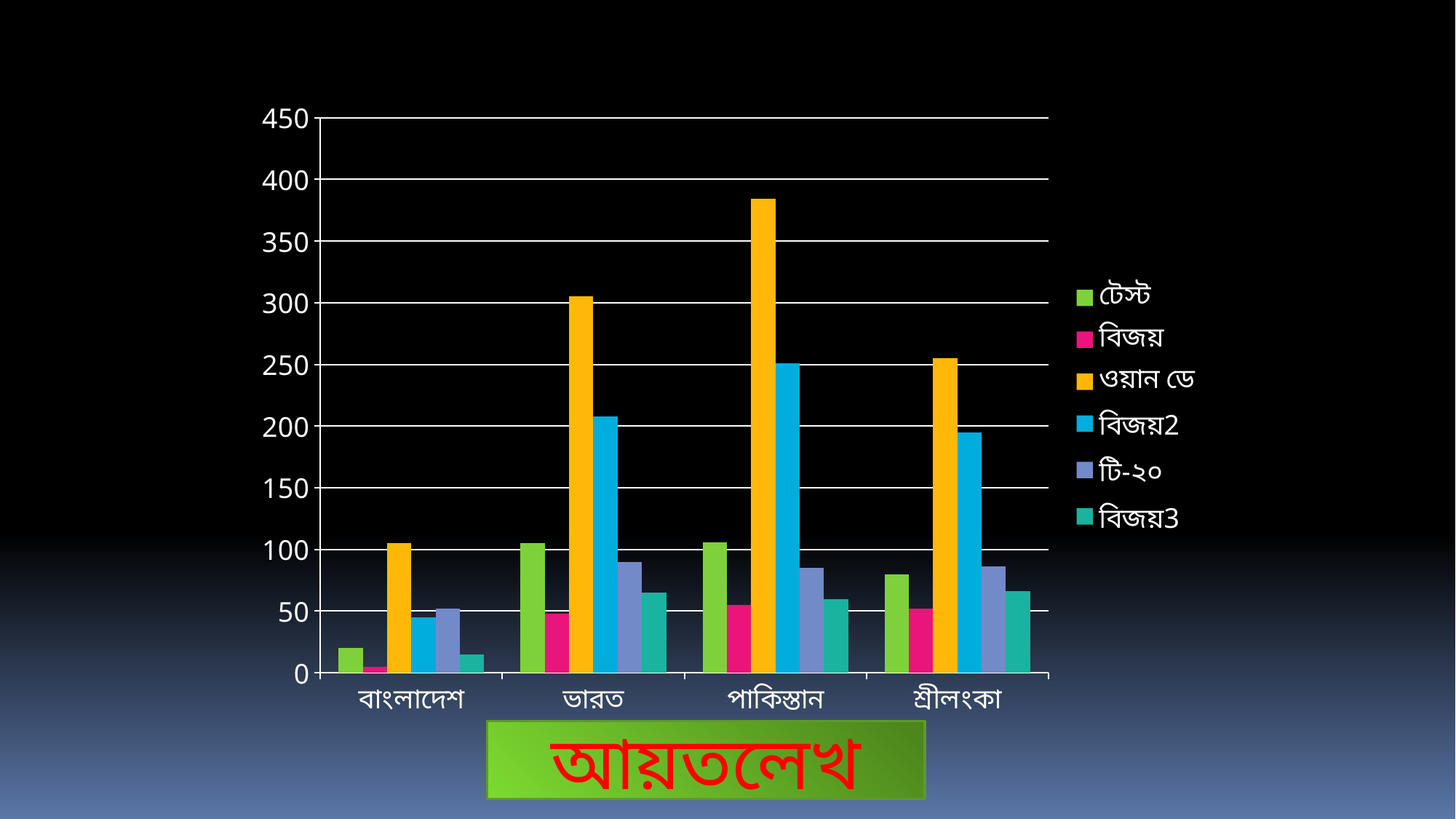
Is the value for বিজয়2 in পাকিস্তান greater or less than 200? greater What text is shown in the green box below the chart? আয়তলেখ How many categories are shown on the x axis? 4 Which category has the highest value for ওয়ান ডে? পাকিস্তান Which is larger: the ওয়ান ডে value for ভারত or for পাকিস্তান? পাকিস্তান Which category has the lowest value for বিজয়? বাংলাদেশ What kind of chart is shown on the slide? bar chart Is the value for টেস্ট in বাংলাদেশ greater or less than 50? less How many series does the legend list? 6 Is the value for ওয়ান ডে in পাকিস্তান greater or less than 350? greater Which category has the lowest value for টেস্ট? বাংলাদেশ